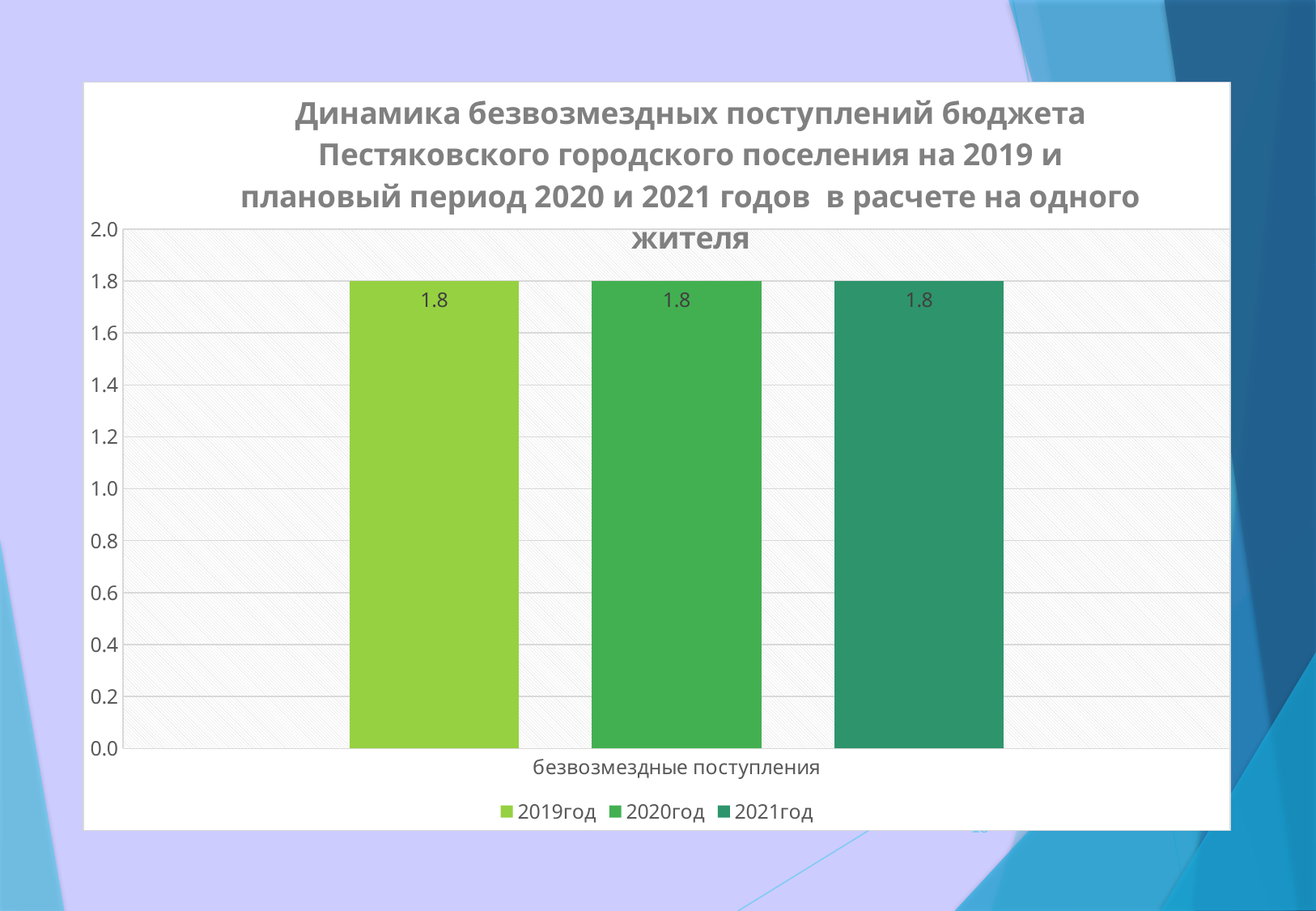
How many bars are plotted in the chart? 3 What is the value for 2020год (2020 year) in the chart? 1.8 Is the value for 2019год greater or less than 2.0? less Which legend entry is shown in the lightest green colour? 2019год What is the value for 2021год (2021 year) in the chart? 1.8 What kind of chart is shown on the slide? bar chart What is the category label shown on the x axis? безвозмездные поступления Is the value for 2020год greater or less than 1.0? greater How many series does the legend list? 3 Do the values rise, fall, or stay the same from 2019год to 2021год? stay the same What is the difference between the values for 2019год and 2021год? 0 What is the value for 2019год (2019 year) in the chart? 1.8